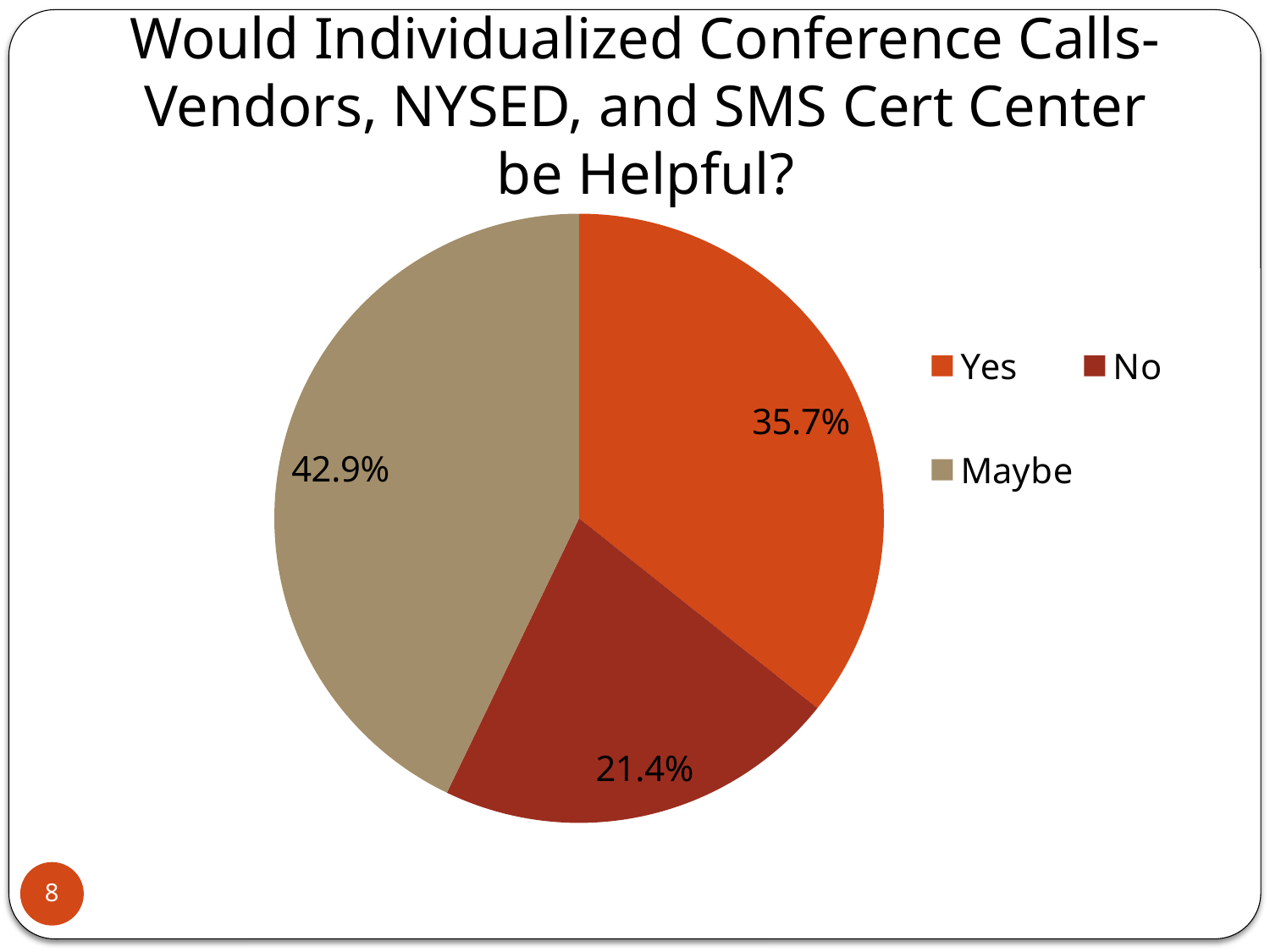
What share of the pie is labelled "No"? 21.4% How many slices does the pie chart have? 3 Which response has the largest share of the pie? Maybe What share of the pie is labelled "Yes"? 35.7% What kind of chart is shown on the slide? pie chart Which response has the smallest share of the pie? No What is the difference in percentage points between the "Maybe" and "Yes" shares? 7.2 How many entries does the legend list? 3 Which is larger, the "Yes" share or the "No" share? Yes What share of the pie is labelled "Maybe"? 42.9% What colour is the "Maybe" slice? tan What is the difference in percentage points between the "Yes" and "No" shares? 14.3